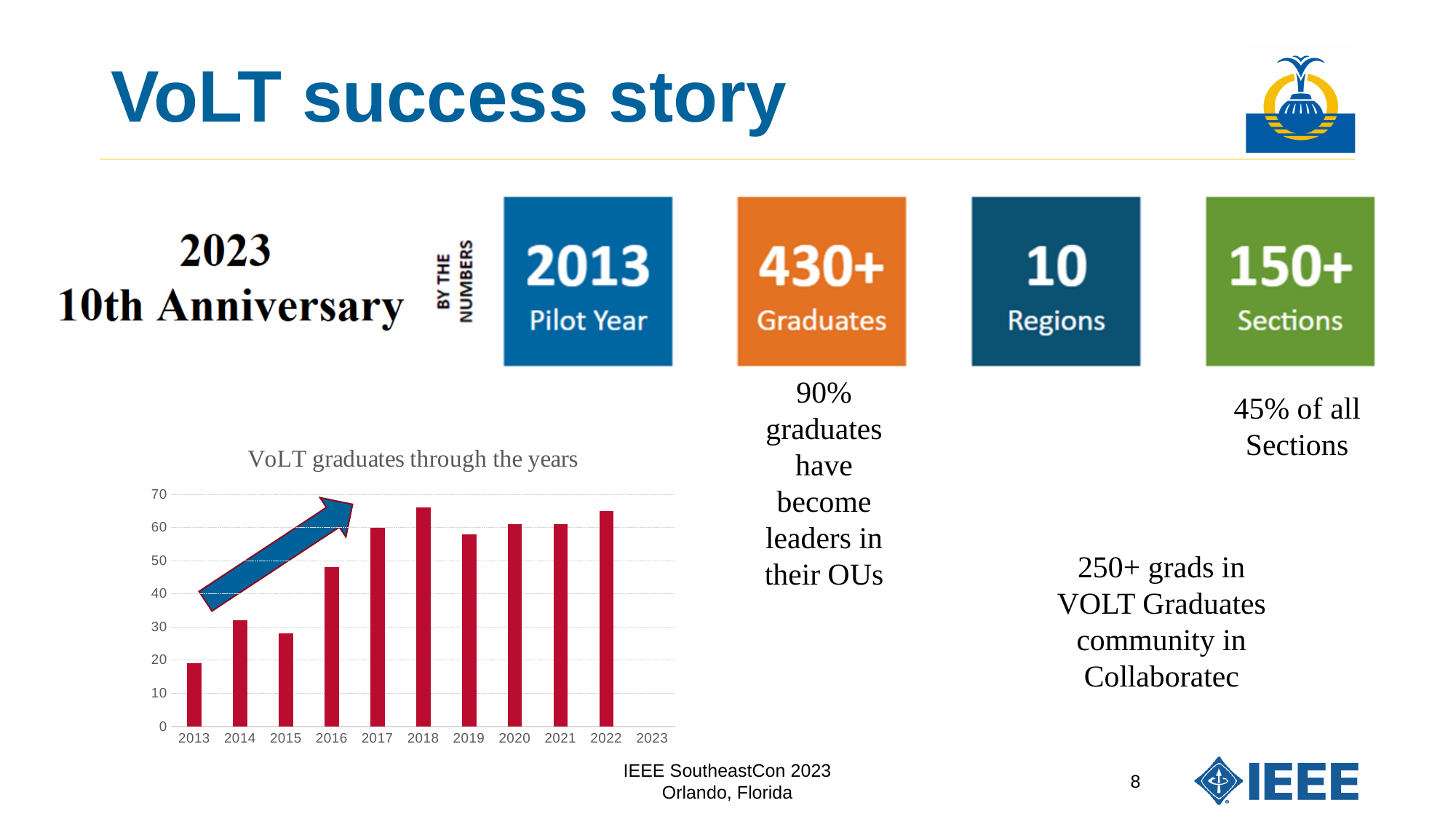
Is the value for 2017 greater or less than 50? greater Which is larger, the value for 2016 or the value for 2015? 2016 Is the value for 2016 greater or less than 40? greater Is the value for 2015 greater or less than 30? less What is the title of the chart on the slide? VoLT graduates through the years What kind of chart is shown on the slide? bar chart Which is larger, the value for 2014 or the value for 2013? 2014 What is the highest value shown on the y axis of the chart? 70 Which year has the lowest bar in the chart? 2013 How many years are labelled on the x axis of the chart? 11 Do the values generally rise or fall from 2013 to 2022? rise